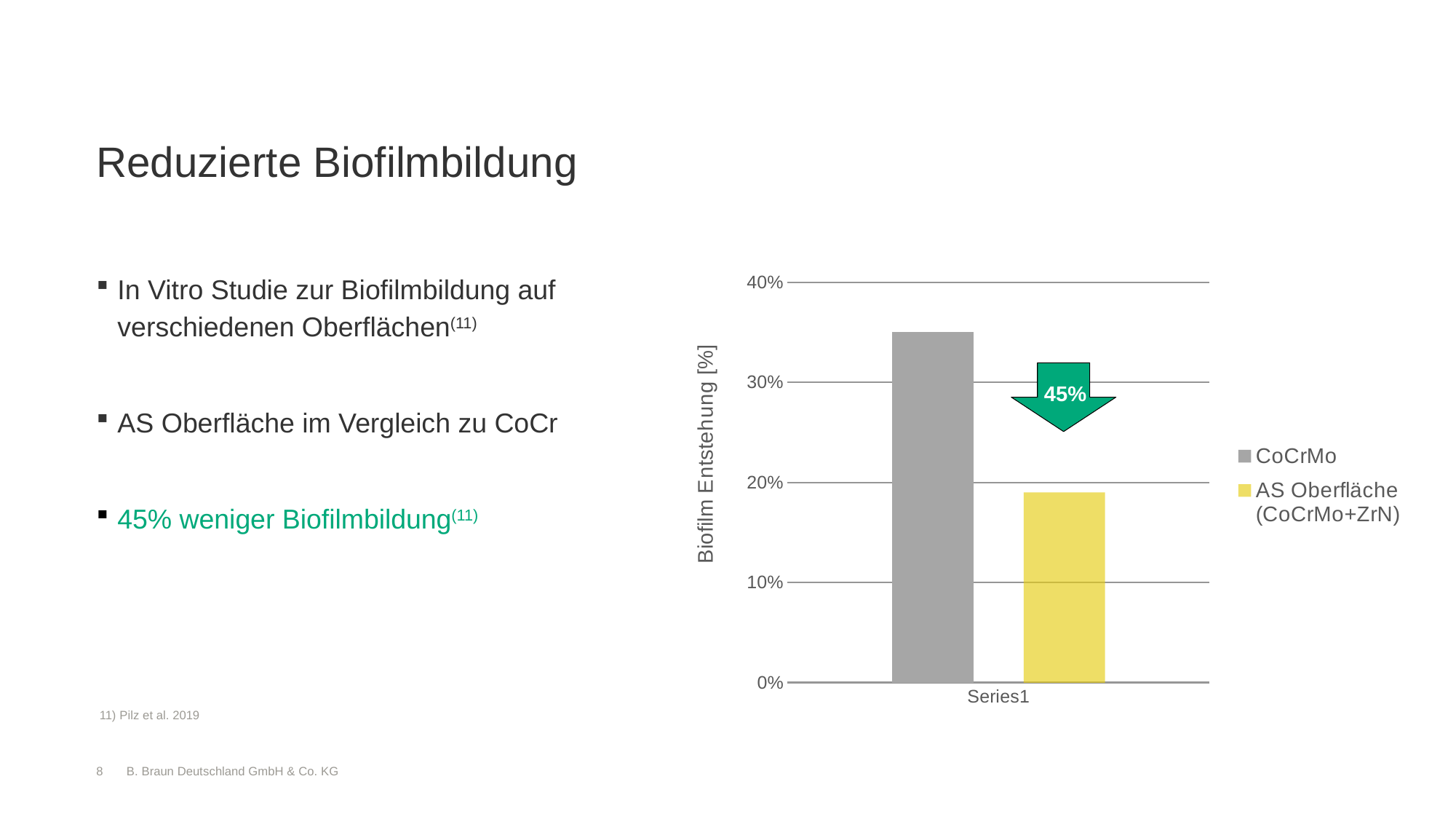
What percentage is printed on the green arrow annotation in the chart? 45% Which series has the higher biofilm formation value? CoCrMo Which series has the lower biofilm formation value? AS Oberfläche (CoCrMo+ZrN) Is the value for CoCrMo larger or smaller than the value for AS Oberfläche (CoCrMo+ZrN)? larger What kind of chart is shown on the slide? bar chart How many categories are shown on the x axis? 1 Is the value for CoCrMo greater or less than 40%? less Is the value for AS Oberfläche (CoCrMo+ZrN) greater or less than 10%? greater How many series does the legend list? 2 Is the value for CoCrMo greater or less than 30%? greater What is the label of the y axis? Biofilm Entstehung [%]